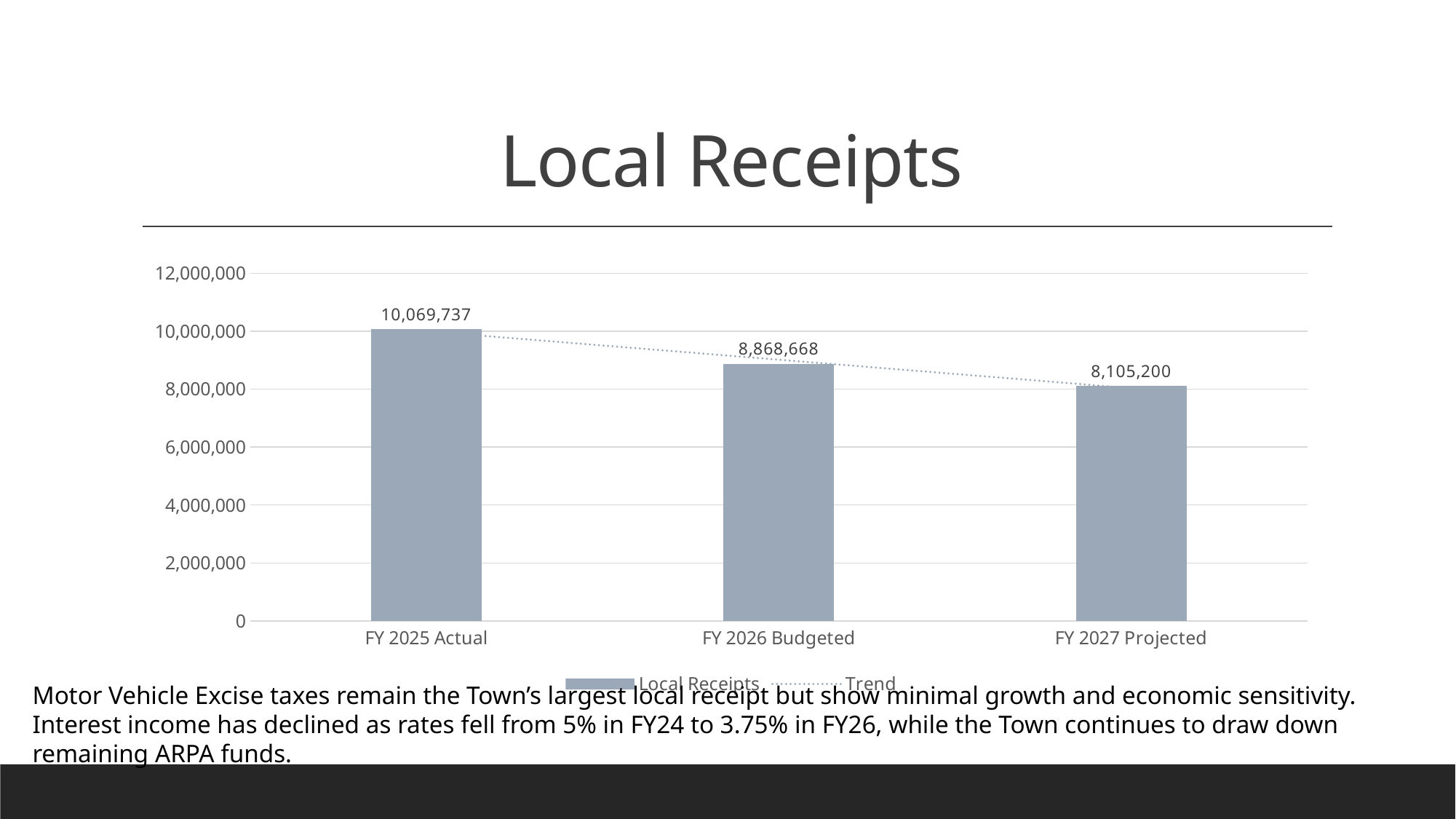
Which is larger, the value for FY 2026 Budgeted or FY 2027 Projected? FY 2026 Budgeted Is the value for FY 2025 Actual greater or less than 10,000,000? greater How many categories are shown on the x axis? 3 Which category has the highest value? FY 2025 Actual What kind of chart is shown on the slide? Bar chart What is the value for FY 2026 Budgeted? 8,868,668 Which category has the lowest value? FY 2027 Projected Do the values rise or fall from FY 2025 Actual to FY 2027 Projected? Fall What is the value for FY 2027 Projected? 8,105,200 What is the difference between the FY 2026 Budgeted and FY 2027 Projected values? 763,468 What is the value for FY 2025 Actual? 10,069,737 What is the difference between the FY 2025 Actual and FY 2026 Budgeted values? 1,201,069